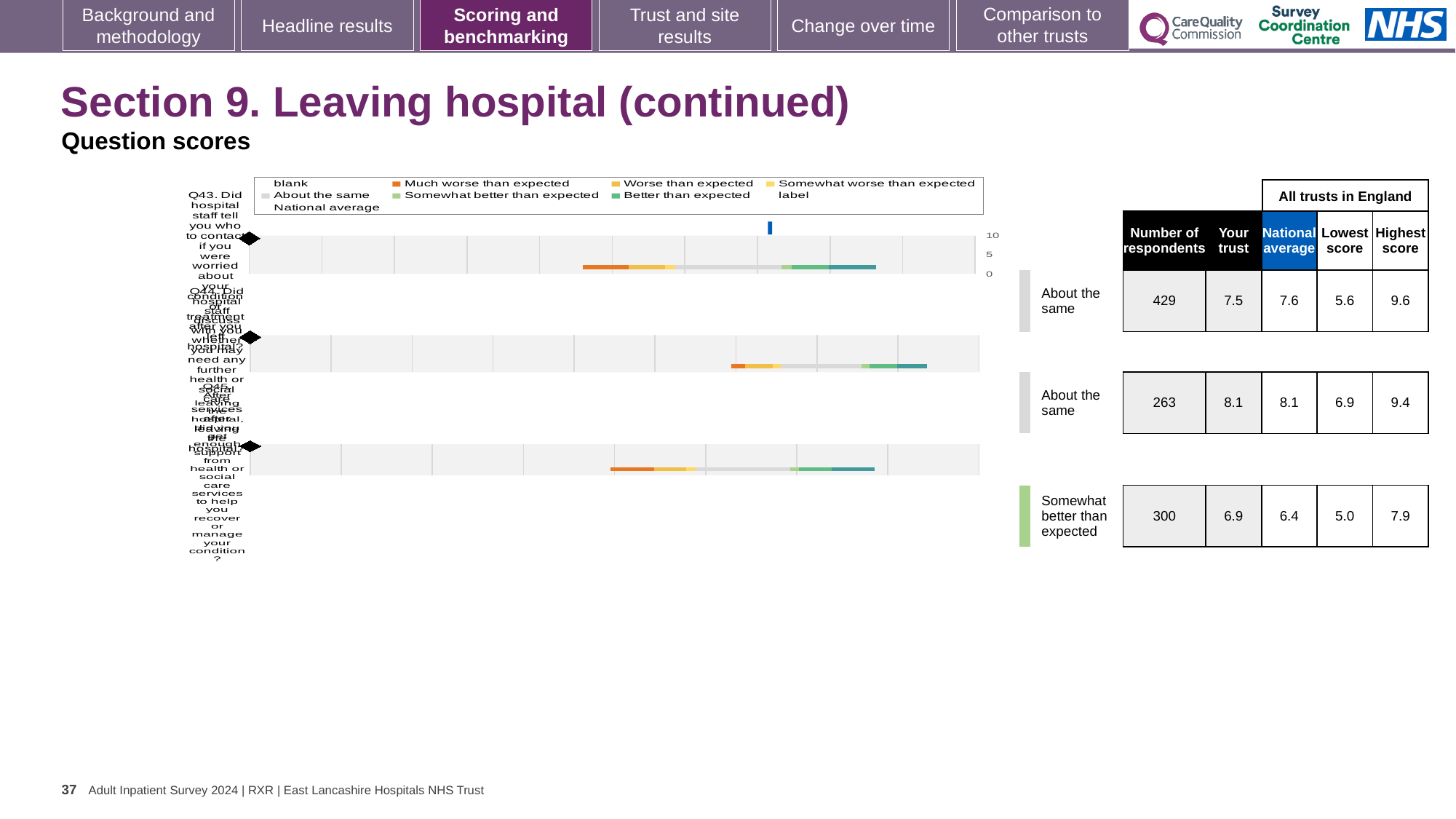
What benchmark category is shown for the third question row? Somewhat better than expected What is the number of respondents for the second question row? 263 For the third question row, what is the difference between the 'Your trust' score and the national average? 0.5 What is the national average for the first question row (Q43)? 7.6 How many questions (rows) are plotted in the question scores chart? 3 Which question row has the highest 'Your trust' score? The second row (8.1) What is the lowest score among all trusts in England for the third question row? 5.0 What is the number of respondents for the first question row (Q43)? 429 What kind of chart is used to show the question scores on this slide? bar chart What is the 'Your trust' score for the first question row (Q43)? 7.5 What is the highest score among all trusts in England for the first question row (Q43)? 9.6 For the first question row (Q43), which is larger: the 'Your trust' score or the national average? National average